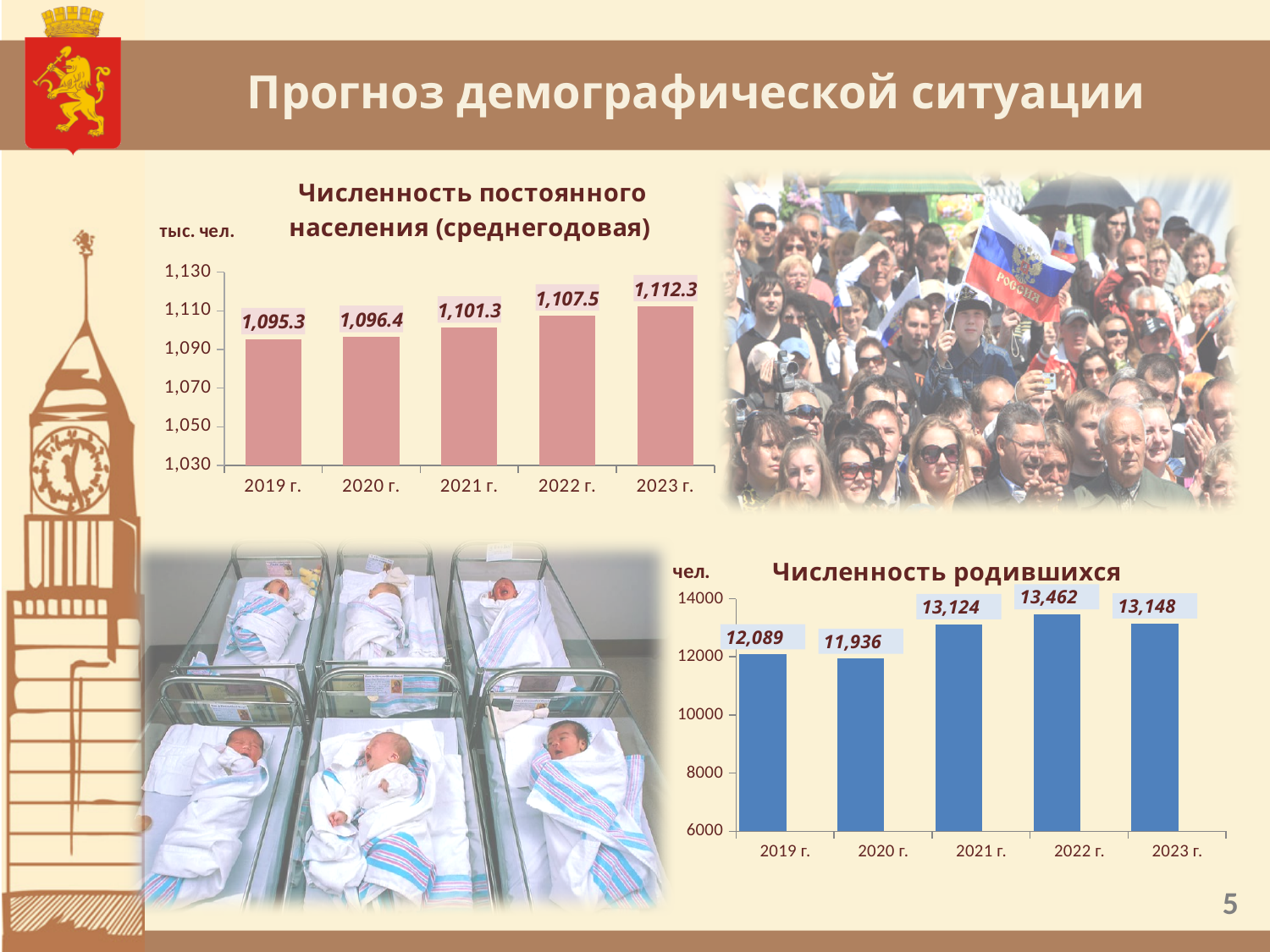
In the chart 'Численность родившихся', which year has the highest value? 2022 г. In the chart 'Численность постоянного населения (среднегодовая)', which year has the lowest value? 2019 г. In the chart 'Численность родившихся', what is the difference between the values for 2022 г. and 2021 г.? 338 In the chart 'Численность постоянного населения (среднегодовая)', do the values rise or fall from 2019 г. to 2023 г.? rise In the chart 'Численность постоянного населения (среднегодовая)', what is the value for 2021 г.? 1,101.3 In the chart 'Численность постоянного населения (среднегодовая)', what is the difference between the values for 2023 г. and 2019 г.? 17.0 In the chart 'Численность родившихся', which year has the lowest value? 2020 г. In the chart 'Численность родившихся', what is the value for 2020 г.? 11,936 In the chart 'Численность постоянного населения (среднегодовая)', what unit is shown above the vertical axis? тыс. чел. How many years are shown in the chart 'Численность родившихся'? 5 In the chart 'Численность постоянного населения (среднегодовая)', which year has the highest value? 2023 г. In the chart 'Численность родившихся', which is larger, the value for 2019 г. or the value for 2023 г.? 2023 г.